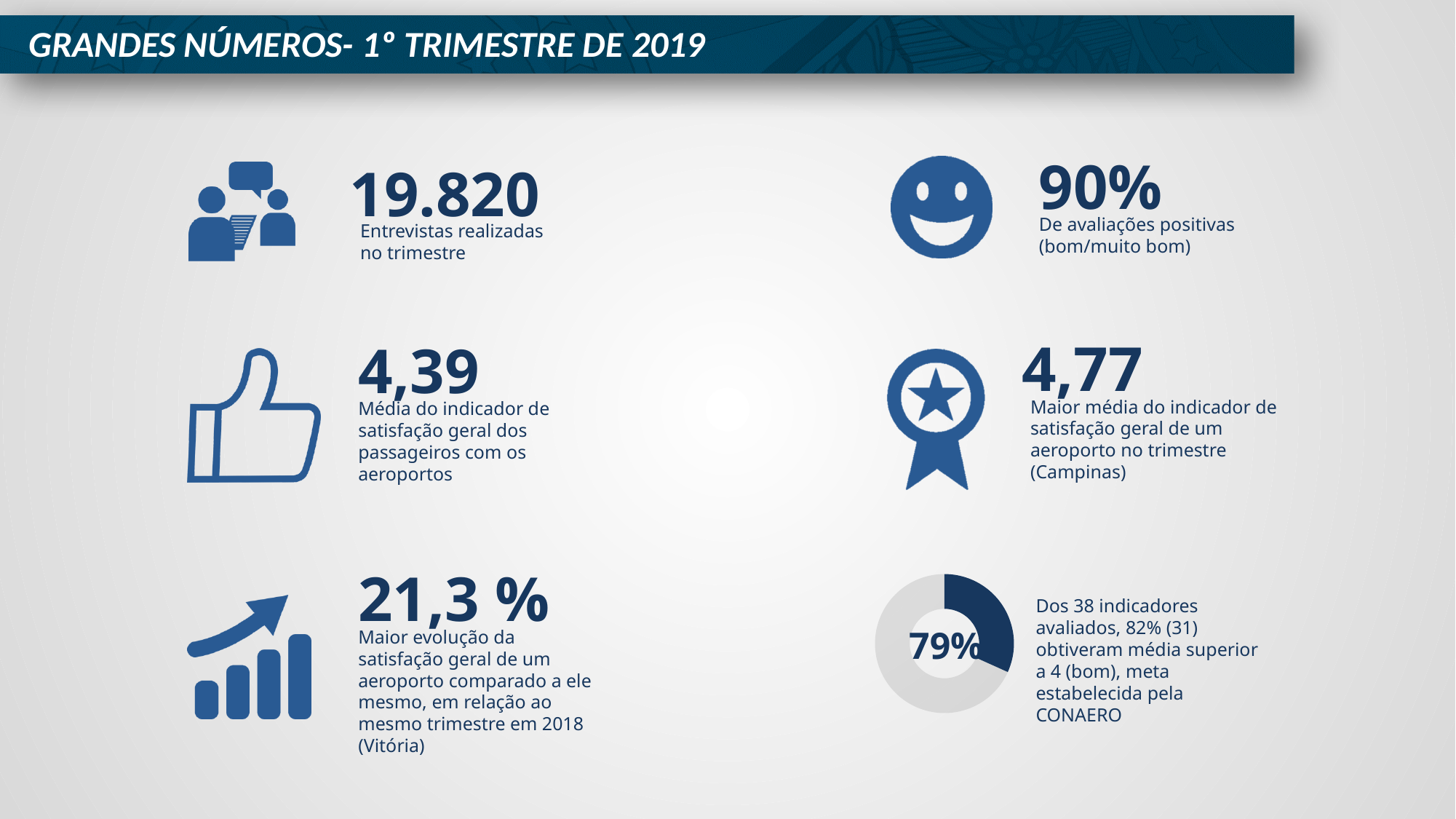
In the donut chart in the bottom right, which segment is larger, the dark blue one or the light grey one? light grey What kind of chart is shown in the bottom right of the slide? Pie chart (donut) How many segments does the donut chart in the bottom right have? 2 What value is printed in the centre of the donut chart in the bottom right? 79% What colour is the highlighted (smaller) segment of the donut chart in the bottom right? Dark blue What is the title of the slide containing the donut chart? GRANDES NÚMEROS- 1º TRIMESTRE DE 2019